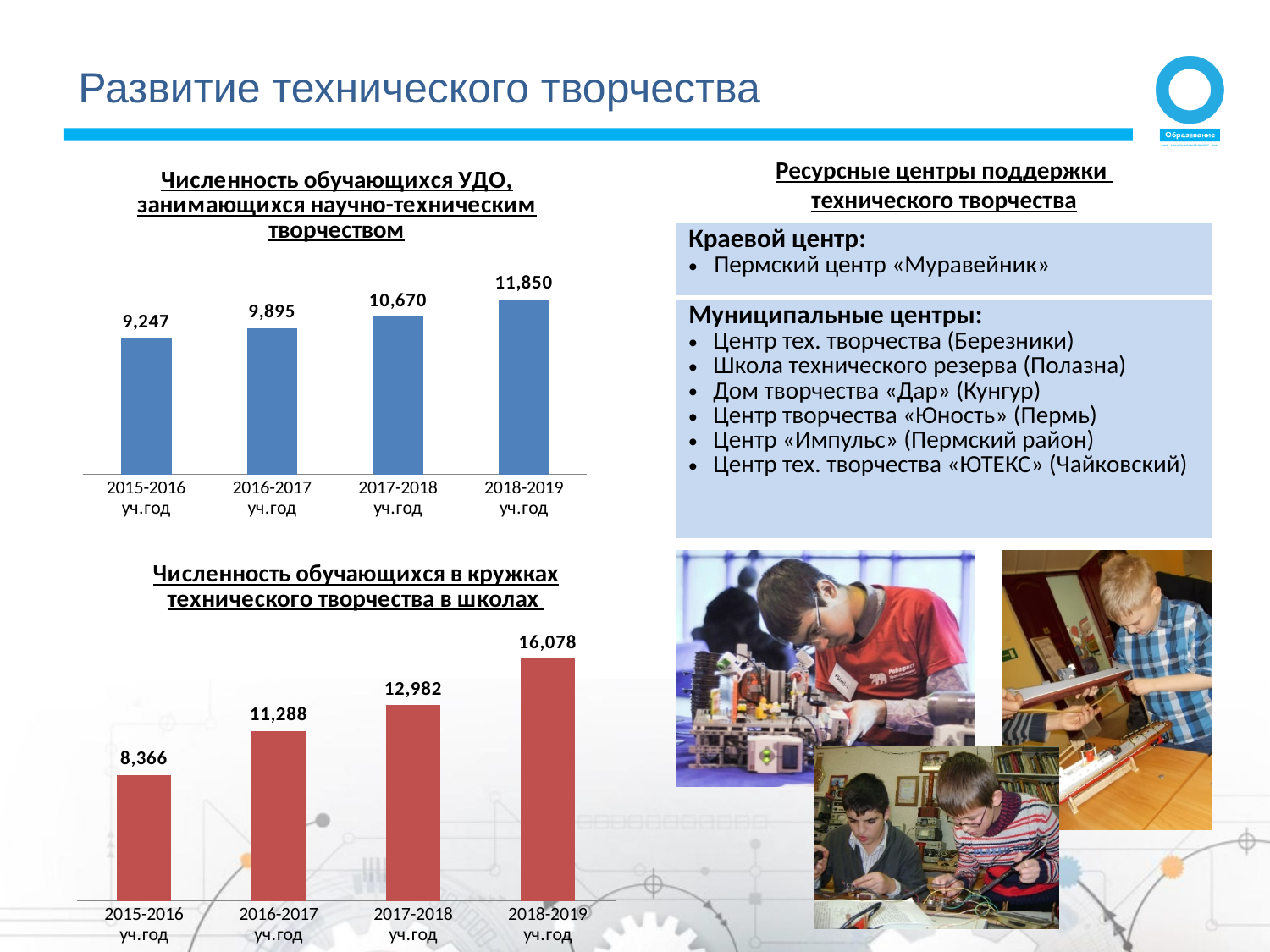
In the top-left chart (Численность обучающихся УДО), what is the difference between the 2018-2019 and 2015-2016 values? 2,603 In the bottom-left chart (Численность обучающихся в кружках технического творчества в школах), what is the value for 2017-2018 уч.год? 12,982 In the top-left chart (Численность обучающихся УДО), which year has the lowest value? 2015-2016 уч.год What type of chart is the top-left chart (Численность обучающихся УДО)? Bar chart In the bottom-left chart (Численность обучающихся в кружках технического творчества в школах), what is the difference between the 2018-2019 and 2015-2016 values? 7,712 In the top-left chart (Численность обучающихся УДО), what is the value for 2016-2017 уч.год? 9,895 Which is larger: the 2017-2018 value in the top-left chart or the 2017-2018 value in the bottom-left chart? The bottom-left chart (12,982) How many years (categories) are shown in the bottom-left chart? 4 In the top-left chart (Численность обучающихся УДО), what is the value for 2018-2019 уч.год? 11,850 In the bottom-left chart (Численность обучающихся в кружках технического творчества в школах), what is the value for 2015-2016 уч.год? 8,366 In the bottom-left chart (Численность обучающихся в кружках технического творчества в школах), do the values rise or fall from 2015-2016 to 2018-2019? Rise In the bottom-left chart (Численность обучающихся в кружках технического творчества в школах), which year has the highest value? 2018-2019 уч.год